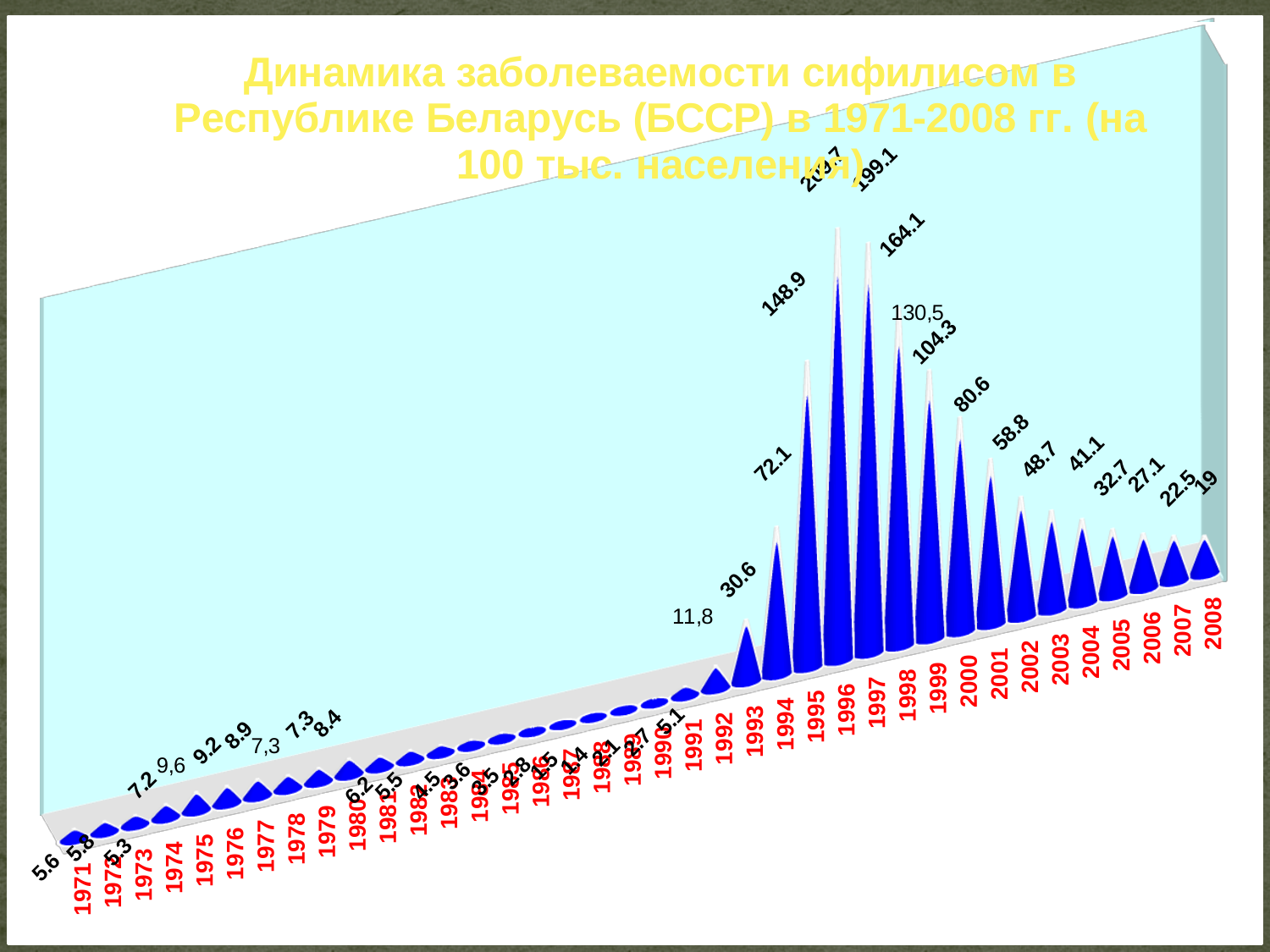
Do the values rise or fall from 1997 to 2008? fall Which year has the highest value? 1996 What value is shown for 1993? 30.6 Which is larger, the value for 1995 or the value for 1998? 1998 What value is shown for 1997? 199.1 What is the difference between the values for 2007 and 2008? 3.5 What is the difference between the values for 1994 and 1993? 41.5 What value is shown for 2008? 19 How many years are shown on the x axis? 38 What value is shown for 1971? 5.6 What value is shown for 1999? 130,5 What value is shown for 2001? 80.6